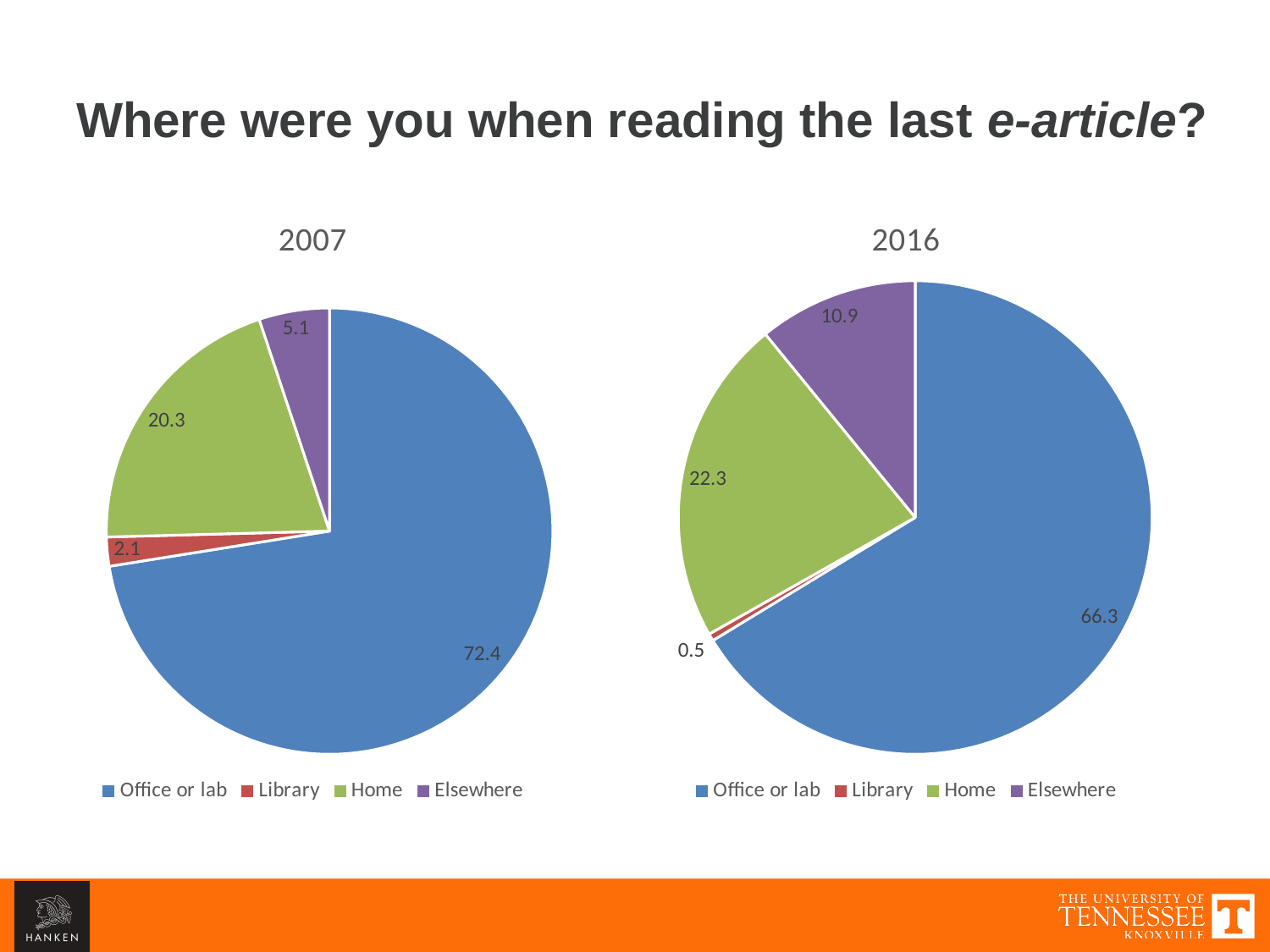
In the 2016 pie chart, what is the difference between the Home and Elsewhere values? 11.4 What kind of chart is the 2016 chart? Pie chart What is the difference between the Office or lab values in the 2007 and 2016 pie charts? 6.1 In the 2007 pie chart, which category has the largest slice? Office or lab In the 2007 pie chart, what is the value for Office or lab? 72.4 What are the titles of the two charts on the slide? 2007 and 2016 In the 2016 pie chart, what is the value for Library? 0.5 In the 2016 pie chart, what is the value for Home? 22.3 In the 2007 pie chart, what is the value for Elsewhere? 5.1 Which is larger: the Elsewhere value in the 2007 pie chart or the Elsewhere value in the 2016 pie chart? 2016 How many categories does the 2007 pie chart show? 4 In the 2016 pie chart, which category has the smallest slice? Library